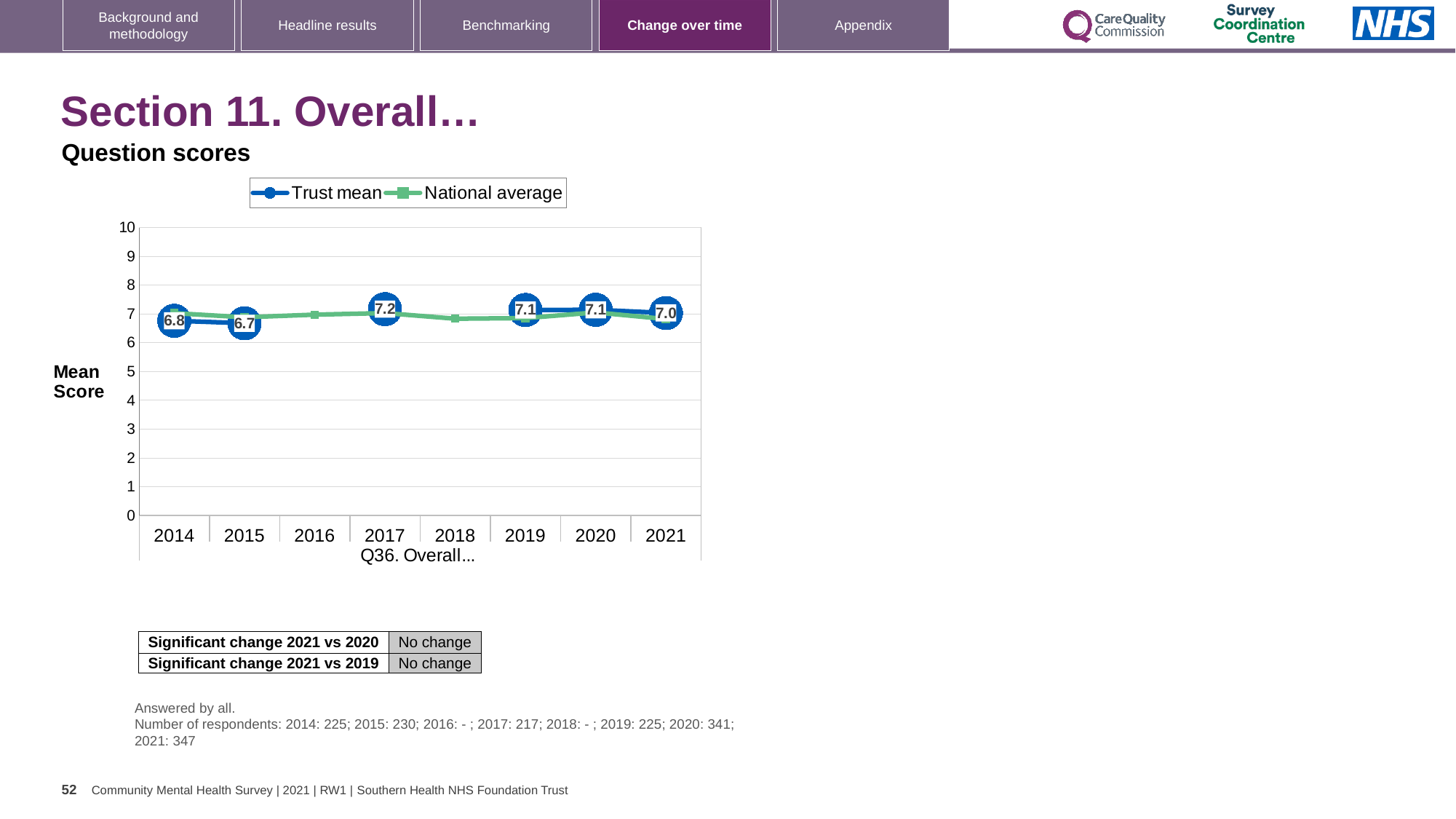
How many years are shown on the x axis? 8 In which year is the Trust mean score lowest? 2015 Is the National average value for 2016 greater or less than 5? greater What is the difference between the Trust mean score in 2017 and in 2015? 0.5 What is the Trust mean score for 2014? 6.8 What kind of chart is shown on the slide? Line chart In which year is the Trust mean score highest? 2017 Which is larger, the Trust mean score for 2014 or for 2020? 2020 What is the Trust mean score for 2021? 7.0 How many series does the legend list? 2 What is the label on the y axis of the chart? Mean Score What is the Trust mean score for 2017? 7.2